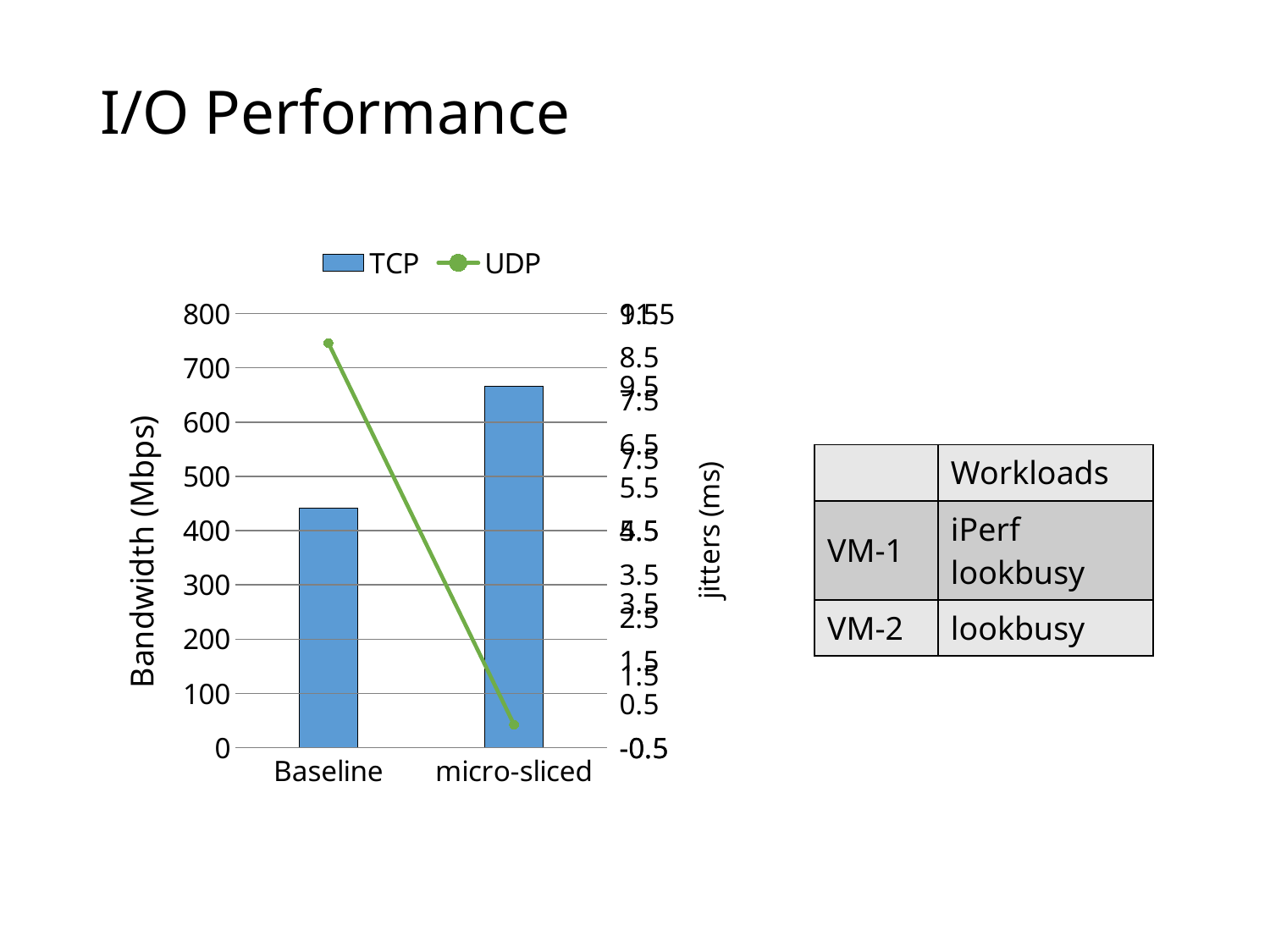
What kind of chart is used to plot the TCP series? bar chart Which category has the higher TCP bandwidth, Baseline or micro-sliced? micro-sliced What kind of chart is used to plot the UDP series? line chart Is the TCP bandwidth for Baseline greater or less than 400? greater Is the TCP bandwidth for Baseline greater or less than 500? less Does the UDP line rise or fall from Baseline to micro-sliced? fall Is the TCP bandwidth for micro-sliced greater or less than 600? greater How many categories are shown on the x axis of the chart? 2 Which category has the lowest TCP bandwidth? Baseline How many series does the chart legend list? 2 What is the title of the left vertical axis of the chart? Bandwidth (Mbps)